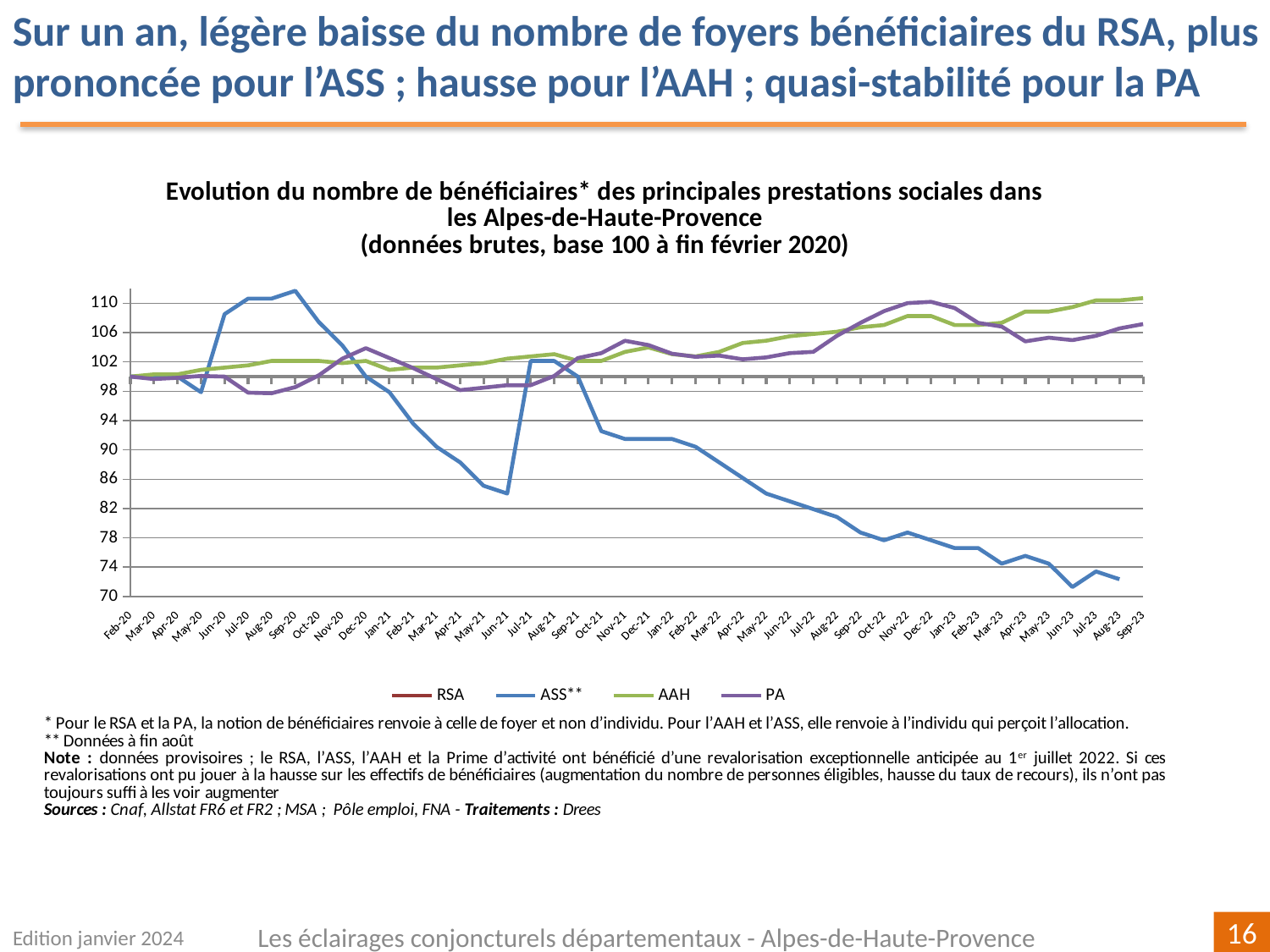
How many series does the legend list? 4 Is the value for PA at Sep-23 greater or less than 102? greater Does the ASS** series overall rise or fall between Feb-20 and Sep-23? fall Which series has the highest value at Sep-23? AAH What kind of chart is shown on the slide? line chart What is the base period of the index (base 100) according to the chart title? fin février 2020 Which series are listed in the legend? RSA, ASS**, AAH, PA Is the value for ASS** at Sep-20 greater or less than 110? greater Is the value for ASS** at Jun-21 greater or less than 86? less